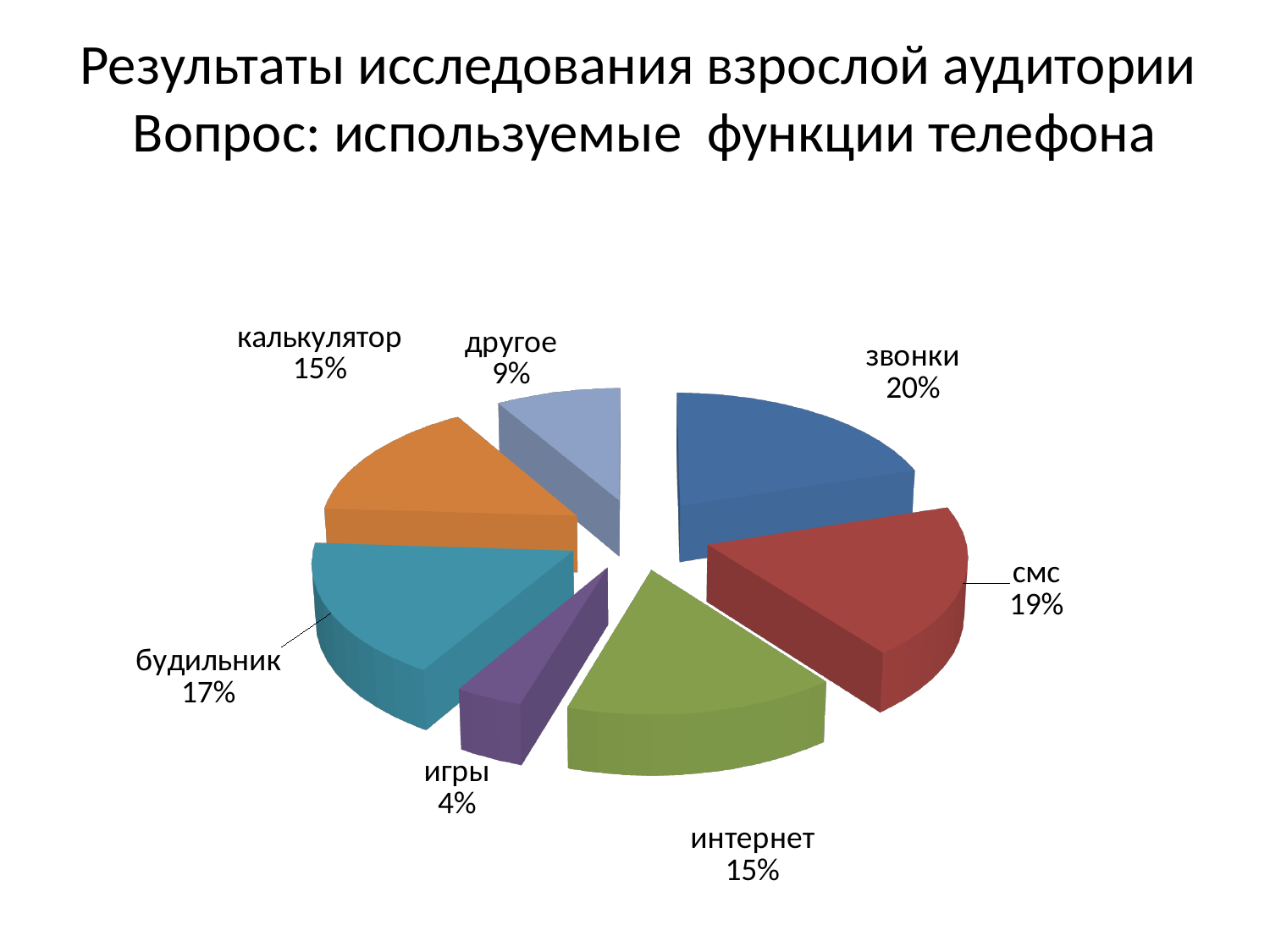
What share of the pie does другое have? 9% What share of the pie does звонки have? 20% What share of the pie does смс have? 19% Which is larger, the share of будильник or the share of другое? будильник What kind of chart is shown on the slide? pie chart Which category has the smallest share of the pie? игры What is the difference between the shares of звонки and игры? 16% What is the difference between the shares of будильник and интернет? 2% How many categories (slices) does the pie chart have? 7 Which category has the largest share of the pie? звонки